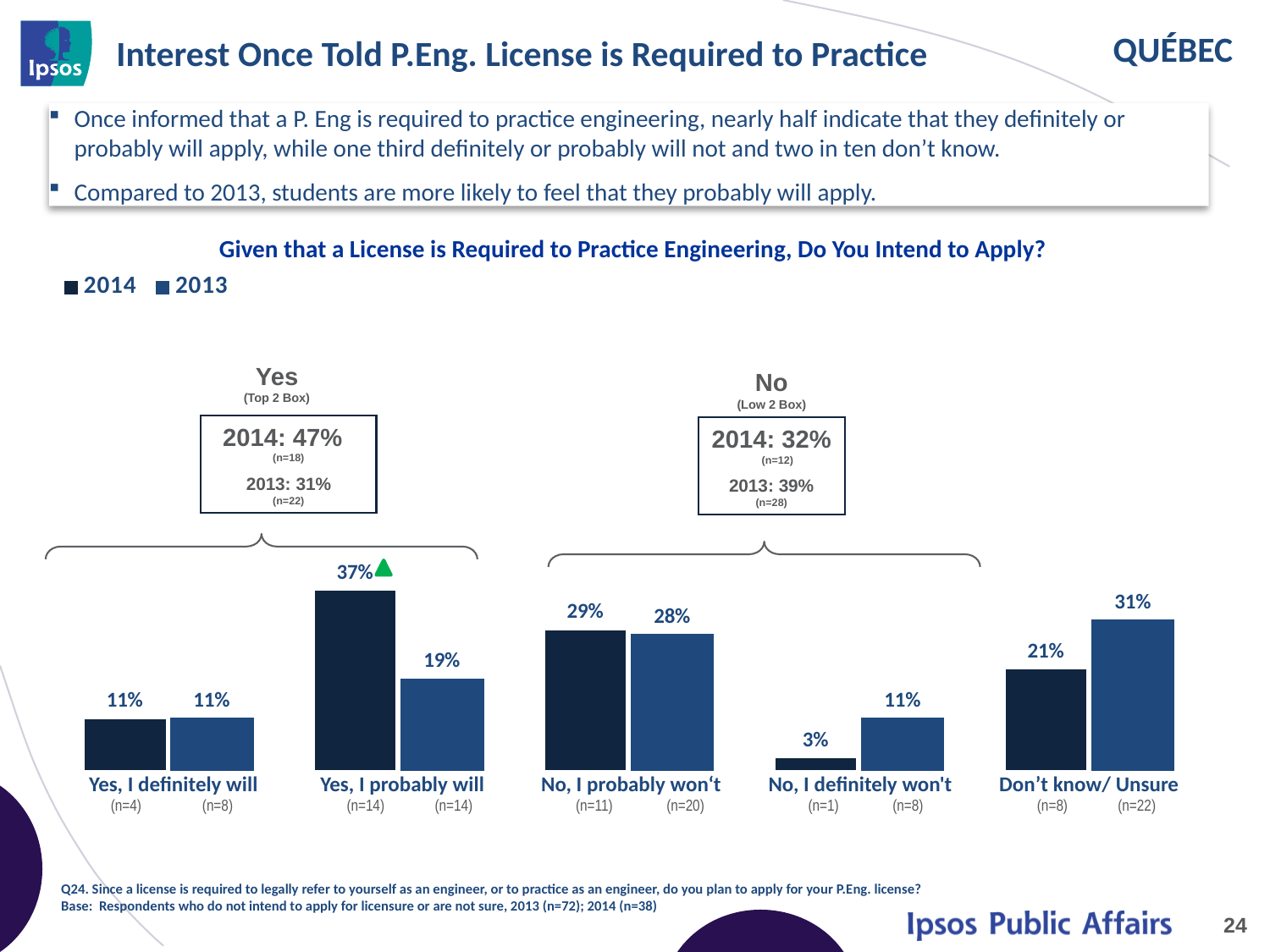
What is the 2013 value for "No, I probably won't"? 28% What kind of chart is shown on the slide? Bar chart Which category has the highest 2014 value? Yes, I probably will What is the 2014 value for "Yes, I probably will"? 37% What is the difference between the 2014 and 2013 values for "Yes, I probably will"? 18% How many response categories are shown on the x axis? 5 What is the 2013 value for "Don't know/ Unsure"? 31% What is the 2014 value for "No, I definitely won't"? 3% What is the title of the chart? Given that a License is Required to Practice Engineering, Do You Intend to Apply? Which is larger for "Don't know/ Unsure": the 2014 value or the 2013 value? 2013 How many series does the legend list? 2 Which category has the lowest 2014 value? No, I definitely won't